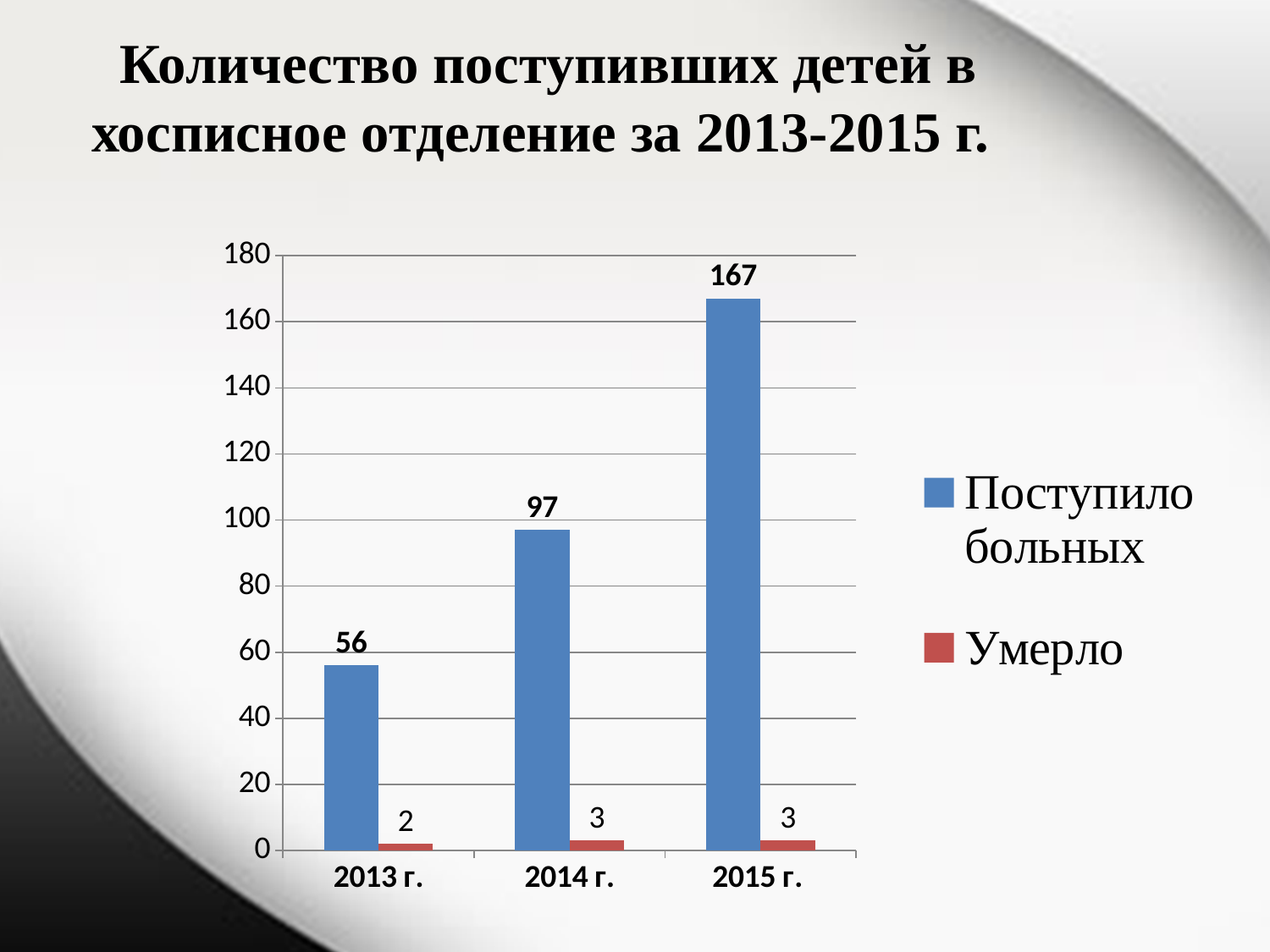
Which year has the highest value for "Поступило больных"? 2015 г. How many years are shown on the x axis? 3 What is the difference between the "Поступило больных" values for 2015 г. and 2014 г.? 70 What kind of chart is shown on the slide? bar chart What is the value for "Поступило больных" in 2015 г.? 167 How many series does the legend list? 2 Is the value for "Поступило больных" in 2014 г. greater or less than 100? less Do the "Поступило больных" values rise or fall from 2013 г. to 2015 г.? rise Which year has the lowest value for "Умерло"? 2013 г. Which is larger: "Поступило больных" in 2014 г. or in 2013 г.? 2014 г. What is the value for "Поступило больных" in 2013 г.? 56 What is the value for "Умерло" in 2014 г.? 3